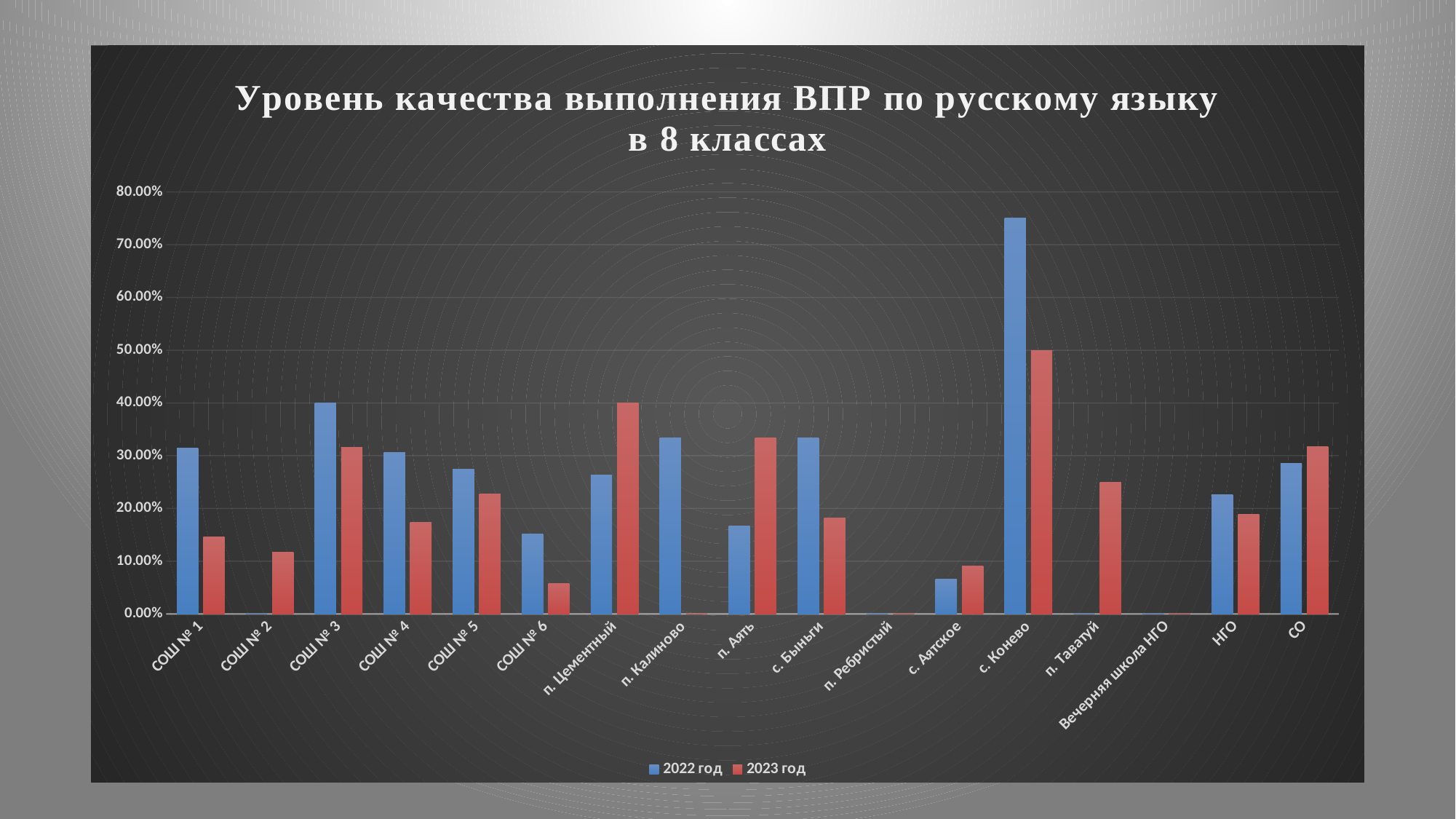
For п. Цементный, which series has the larger value, 2022 год or 2023 год? 2023 год Is the 2022 год value for с. Аятское greater or less than 10.00%? less Which category has the highest value for the 2023 год series? с. Конево Is the 2022 год value for с. Конево greater or less than 70.00%? greater Which category has the highest value for the 2022 год series? с. Конево How many categories (schools) are shown on the x axis? 17 Is the 2023 год value for СОШ № 6 greater or less than 10.00%? less How many series does the legend list? 2 For СОШ № 1, which series has the larger value, 2022 год or 2023 год? 2022 год What kind of chart is shown on the slide? bar chart What are the two series named in the legend? 2022 год and 2023 год